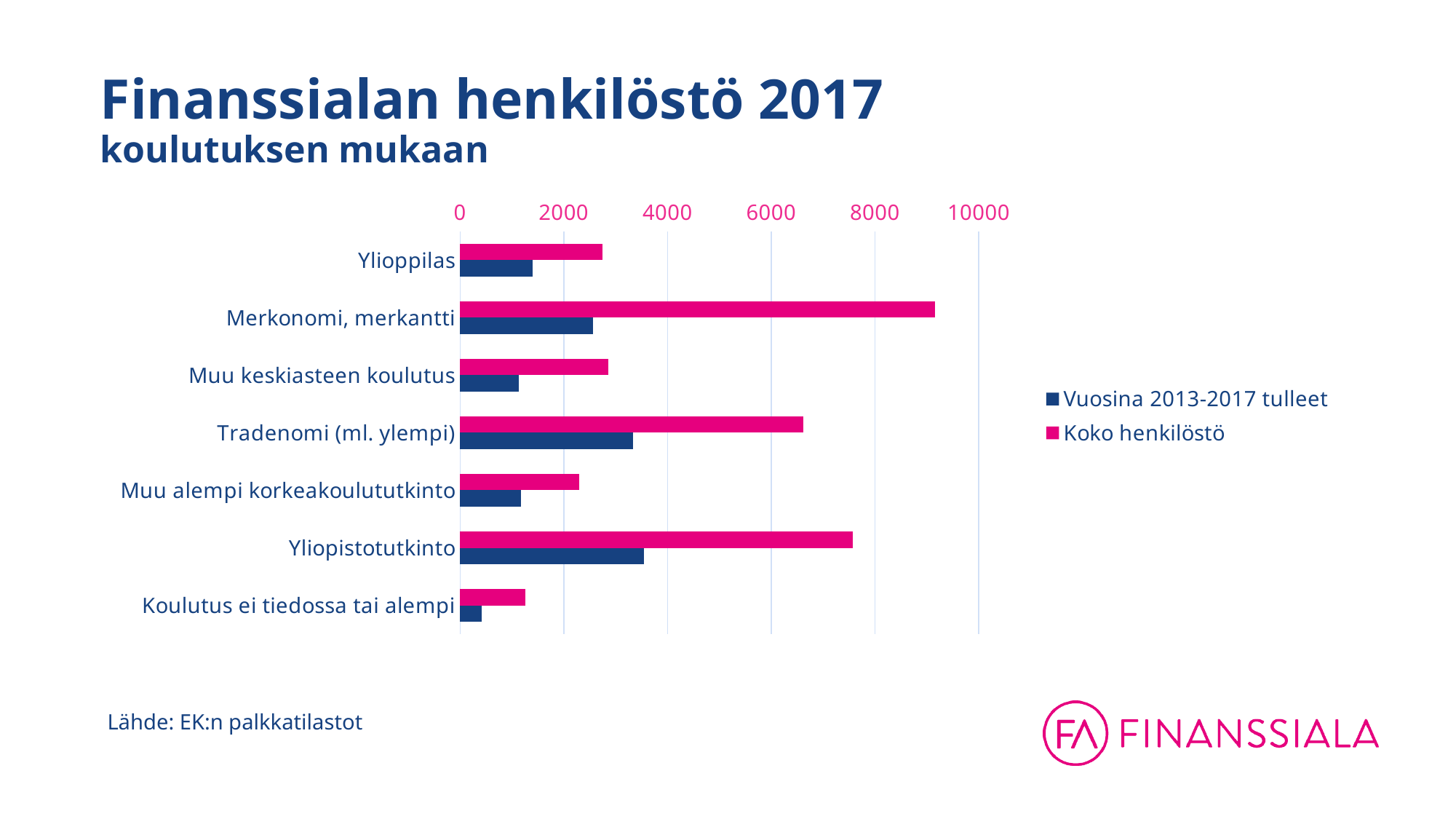
Which category has the highest value for Koko henkilöstö? Merkonomi, merkantti Is the Koko henkilöstö value for Tradenomi (ml. ylempi) greater or less than 6000? greater Is the Koko henkilöstö value for Merkonomi, merkantti greater or less than 8000? greater How many education categories are shown on the chart? 7 Is the Koko henkilöstö value for Yliopistotutkinto greater or less than 8000? less What kind of chart is shown on the slide? bar chart Which category has the lowest value for Vuosina 2013-2017 tulleet? Koulutus ei tiedossa tai alempi How many series does the legend list? 2 For Koko henkilöstö, which is larger: Merkonomi, merkantti or Yliopistotutkinto? Merkonomi, merkantti What is the title of the chart on the slide? Finanssialan henkilöstö 2017 koulutuksen mukaan Which category has the lowest value for Koko henkilöstö? Koulutus ei tiedossa tai alempi